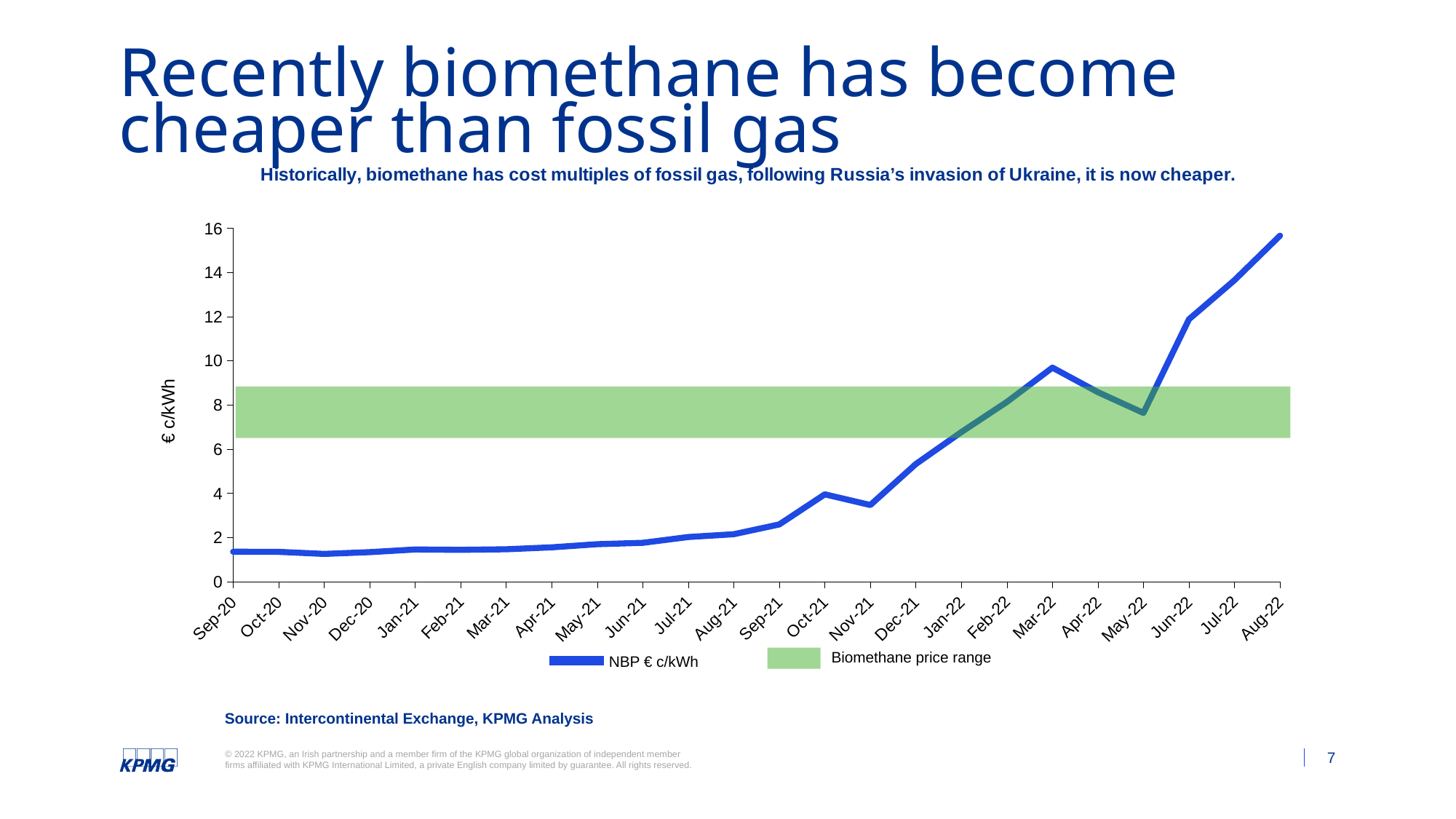
Is the NBP value for Jun-22 greater or less than 10? greater What kind of chart is shown on the slide? line chart Is the NBP value for Sep-20 greater or less than 2? less Does the NBP € c/kWh line generally rise or fall from Sep-20 to Aug-22? rise Is the NBP value for Dec-21 greater or less than 6? less Which is higher, the NBP value for Mar-22 or for May-22? Mar-22 What does the green shaded band in the chart represent, according to the legend? Biomethane price range Which month has the highest NBP € c/kWh value? Aug-22 How many months are shown along the x axis of the chart? 24 How many series does the chart legend list? 2